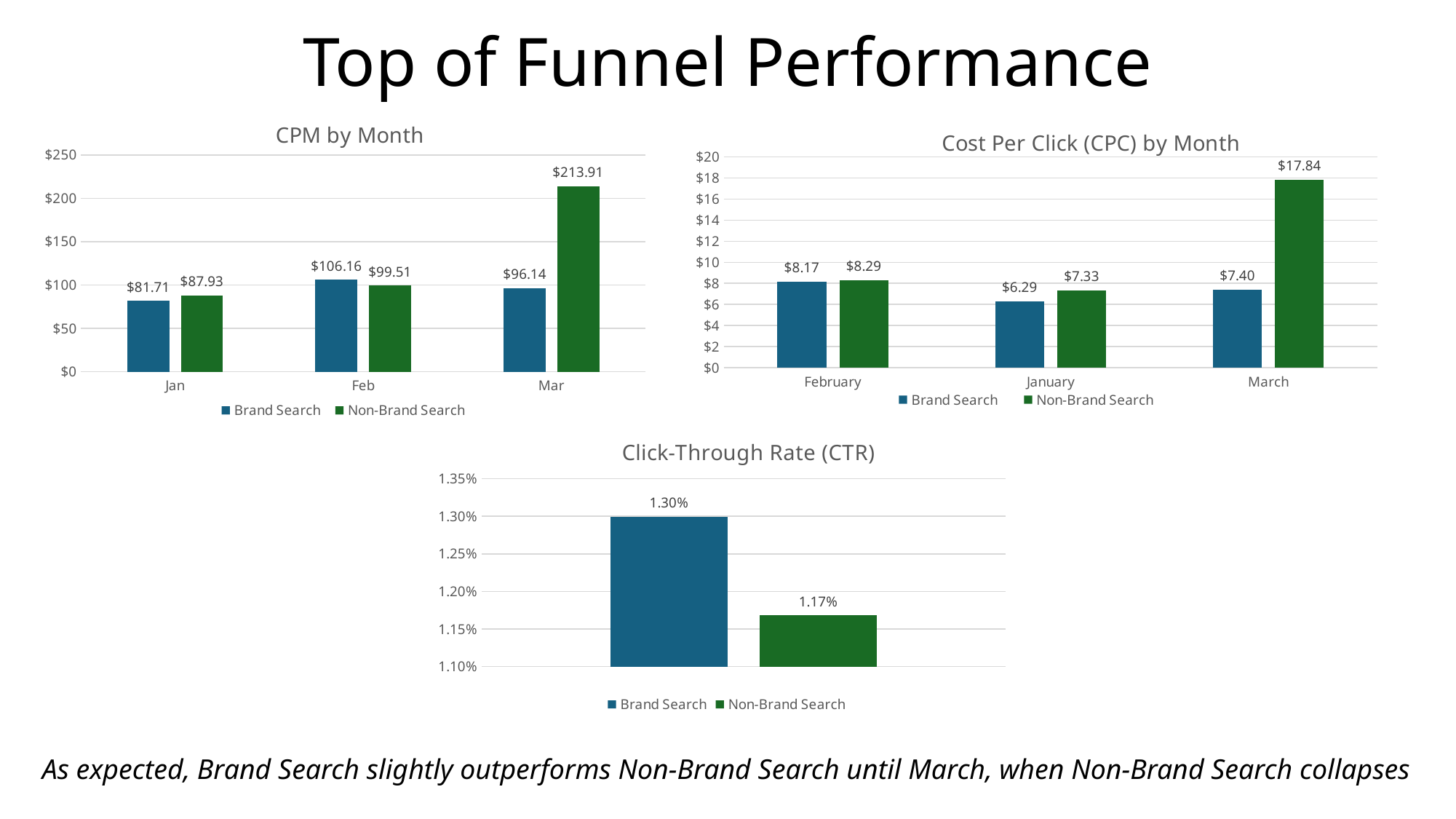
What kind of chart is the Click-Through Rate (CTR) chart? Bar chart In the CPM by Month chart, what is the CPM for Brand Search in Feb? $106.16 In the Cost Per Click (CPC) by Month chart, what is the CPC for Brand Search in January? $6.29 In the Cost Per Click (CPC) by Month chart, which is larger in February: Brand Search or Non-Brand Search CPC? Non-Brand Search In the Cost Per Click (CPC) by Month chart, what is the CPC for Non-Brand Search in March? $17.84 In the CPM by Month chart, what is the difference between the Brand Search and Non-Brand Search CPM in Jan? $6.22 How many months are shown on the x axis of the CPM by Month chart? 3 In the CPM by Month chart, what is the CPM for Non-Brand Search in Mar? $213.91 In the CPM by Month chart, which month has the highest Non-Brand Search CPM? Mar In the Cost Per Click (CPC) by Month chart, which month has the lowest Brand Search CPC? January In the Click-Through Rate (CTR) chart, what is the CTR for Brand Search? 1.30% In the Click-Through Rate (CTR) chart, what is the difference between the Brand Search and Non-Brand Search CTR? 0.13%